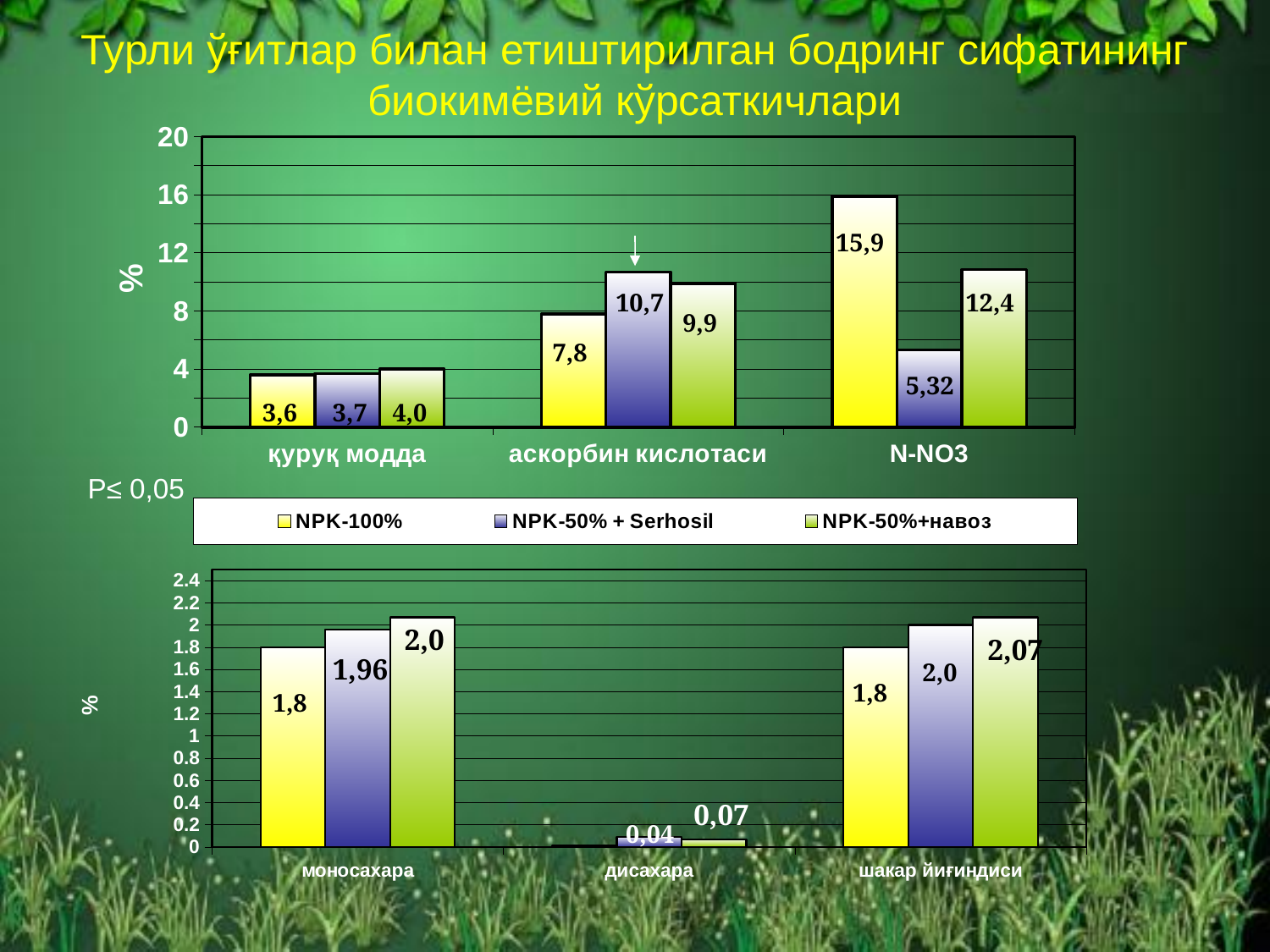
In the top chart, which series has the lowest value in the N-NO3 category? NPK-50% + Serhosil In the bottom chart, what is the value for NPK-50% + Serhosil in the моносахара category? 1,96 How many series does the legend list? 3 In the top chart, what is the value for NPK-100% in the N-NO3 category? 15,9 In the top chart, what is the difference between the NPK-100% and NPK-50%+навоз values in the N-NO3 category? 3,5 How many categories are shown on the x axis of the top chart? 3 In the top chart, what is the value for NPK-50% + Serhosil in the аскорбин кислотаси category? 10,7 In the bottom chart, what is the value for NPK-50%+навоз in the шакар йиғиндиси category? 2,07 What kind of chart is the bottom chart? bar chart In the top chart, what is the value for NPK-50%+навоз in the қуруқ модда category? 4,0 In the top chart, which is larger in the аскорбин кислотаси category: NPK-50% + Serhosil or NPK-50%+навоз? NPK-50% + Serhosil